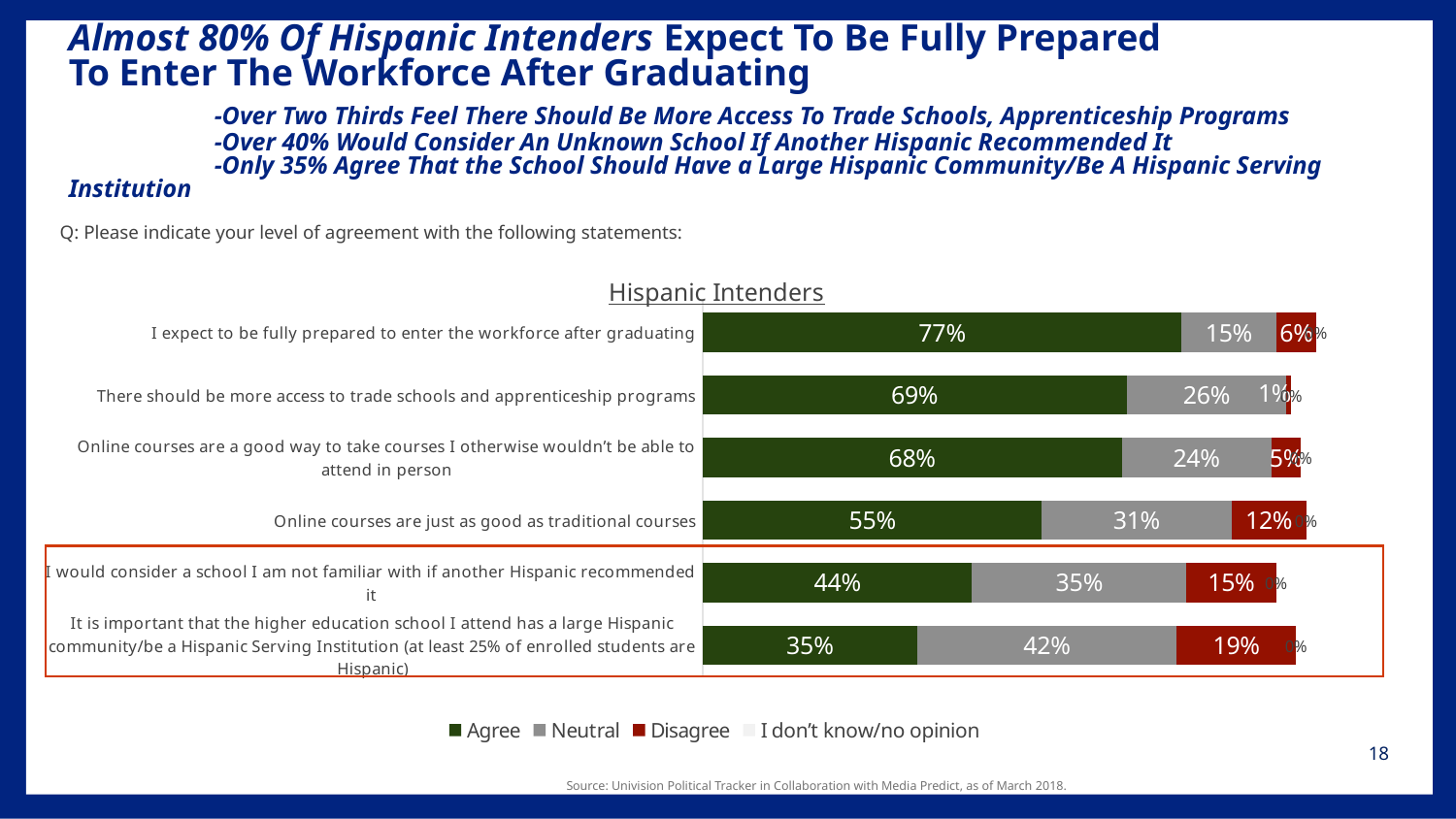
Which statement has the highest Neutral percentage? It is important that the higher education school I attend has a large Hispanic community/be a Hispanic Serving Institution Which statement has the lowest Agree percentage? It is important that the higher education school I attend has a large Hispanic community/be a Hispanic Serving Institution What is the Disagree value for "There should be more access to trade schools and apprenticeship programs"? 1% Which statement has the highest Agree percentage? I expect to be fully prepared to enter the workforce after graduating What percentage of Hispanic Intenders agree with the statement "I expect to be fully prepared to enter the workforce after graduating"? 77% What is the Neutral value for "Online courses are just as good as traditional courses"? 31% What kind of chart is shown on the slide? Stacked bar chart How many statements are shown in the chart? 6 What is the Disagree value for the statement about the school having a large Hispanic community/being a Hispanic Serving Institution? 19% What is the difference in Agree percentage between "I expect to be fully prepared to enter the workforce after graduating" and the statement about a large Hispanic community/Hispanic Serving Institution? 42 percentage points How many series does the legend list? 4 Which has a larger Neutral value: "There should be more access to trade schools and apprenticeship programs" or "Online courses are a good way to take courses I otherwise wouldn't be able to attend in person"? There should be more access to trade schools and apprenticeship programs